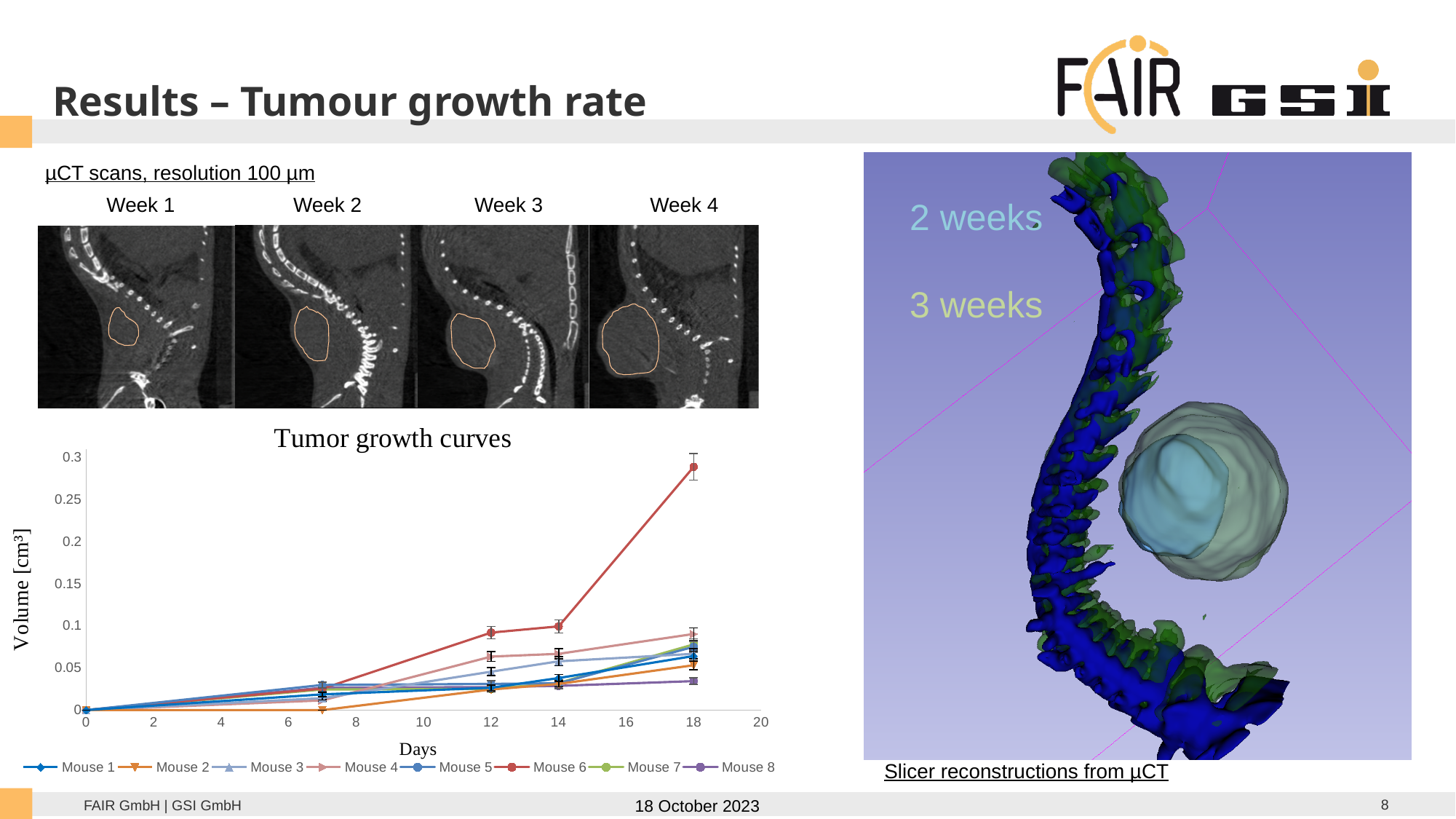
How many measurement time points are plotted for each mouse in the "Tumor growth curves" chart? 5 What kind of chart is "Tumor growth curves"? line chart Does the tumour volume of Mouse 6 rise or fall as the days increase? rise Is the value for Mouse 8 at day 18 greater or less than 0.05? less What is the label of the y axis of the "Tumor growth curves" chart? Volume [cm³] Is the value for Mouse 6 at day 18 greater or less than 0.25? greater Is the value for Mouse 6 at day 12 greater or less than 0.05? greater What is the title of the chart on the slide? Tumor growth curves Which mouse has the highest tumour volume at day 18 in the "Tumor growth curves" chart? Mouse 6 Which mouse has the lowest tumour volume at day 18 in the "Tumor growth curves" chart? Mouse 8 At day 18, which is larger: the value for Mouse 6 or the value for Mouse 8? Mouse 6 How many series does the legend of the "Tumor growth curves" chart list? 8